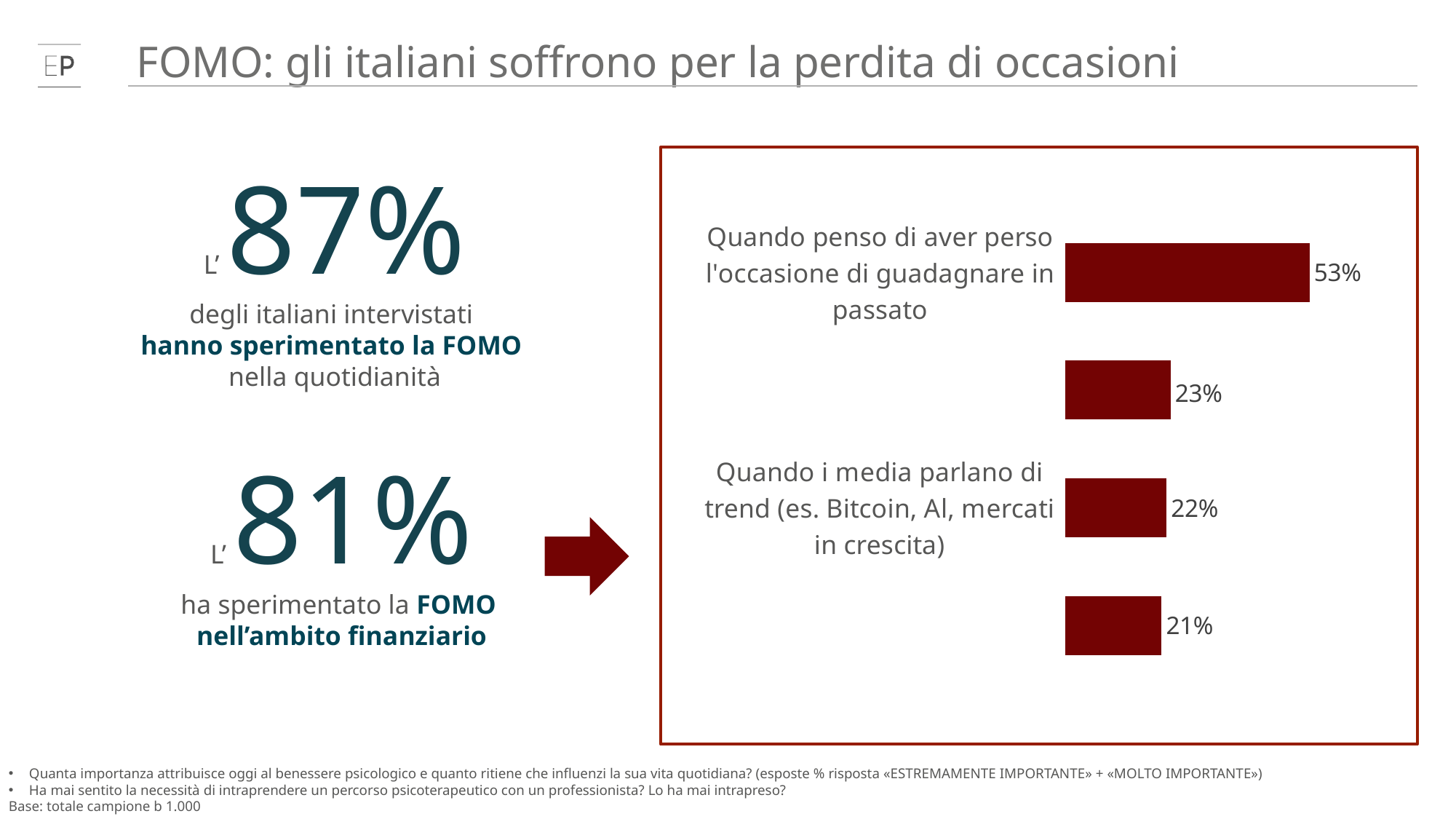
What is the lowest value shown in the chart? 21% Which category has the highest value in the chart? Quando penso di aver perso l'occasione di guadagnare in passato Are the bars in the chart horizontal or vertical? horizontal What type of chart is shown on the slide? bar chart Which is larger: the value for "Quando penso di aver perso l'occasione di guadagnare in passato" or the value for "Quando i media parlano di trend"? Quando penso di aver perso l'occasione di guadagnare in passato How many bars does the chart contain? 4 What is the value for "Quando penso di aver perso l'occasione di guadagnare in passato"? 53% What is the difference between the highest and the lowest value in the chart? 32 percentage points What is the value for "Quando i media parlano di trend (es. Bitcoin, AI, mercati in crescita)"? 22% What is the difference between the value for "Quando penso di aver perso l'occasione di guadagnare in passato" and the value for "Quando i media parlano di trend"? 31 percentage points What colour are the bars in the chart? dark red What is the highest value shown in the chart? 53%